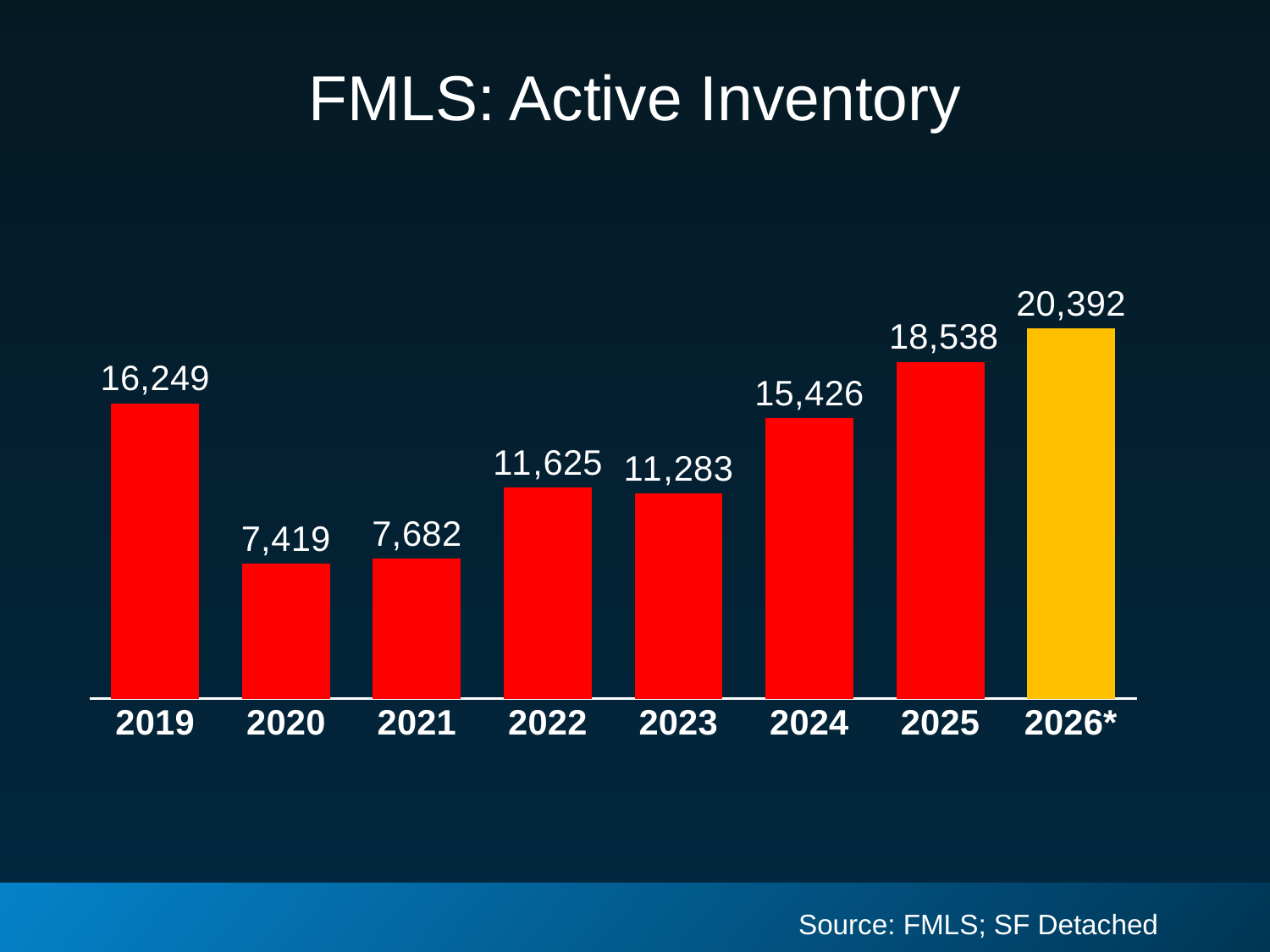
Which is larger, the value for 2022 or the value for 2023? 2022 What is the active inventory value for 2023? 11,283 What is the difference between the 2019 value and the 2020 value? 8,830 What is the active inventory value for 2019? 16,249 What kind of chart is shown on the slide? Bar chart What is the active inventory value for 2026*? 20,392 Which year has the highest active inventory? 2026* Which year has the lowest active inventory? 2020 How many years are shown on the chart? 8 What is the difference between the 2026* value and the 2025 value? 1,854 What is the title of the chart? FMLS: Active Inventory Which is larger, the value for 2020 or the value for 2021? 2021